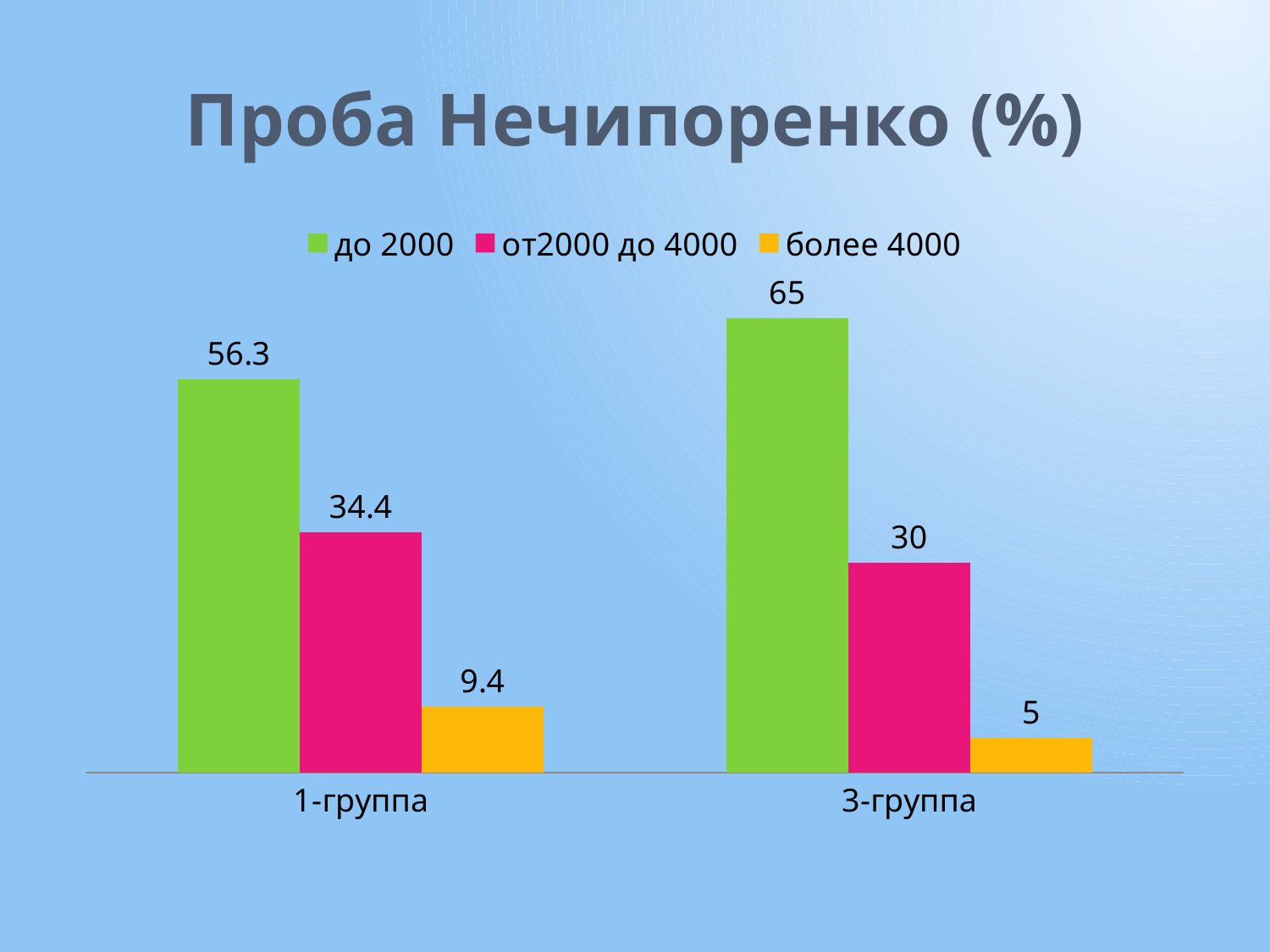
What is the value for "более 4000" in 1-группа? 9.4 What kind of chart is shown on the slide? Bar chart Which series has the lowest value in 1-группа? более 4000 Which is larger: "от2000 до 4000" in 1-группа or in 3-группа? 1-группа How many groups (categories) are shown on the x axis? 2 How many series does the legend list? 3 What is the value for "до 2000" in 3-группа? 65 What is the value for "до 2000" in 1-группа? 56.3 What is the difference between the "более 4000" values for 1-группа and 3-группа? 4.4 What is the difference between the "до 2000" values for 3-группа and 1-группа? 8.7 Which series has the highest value in 3-группа? до 2000 What is the value for "от2000 до 4000" in 3-группа? 30